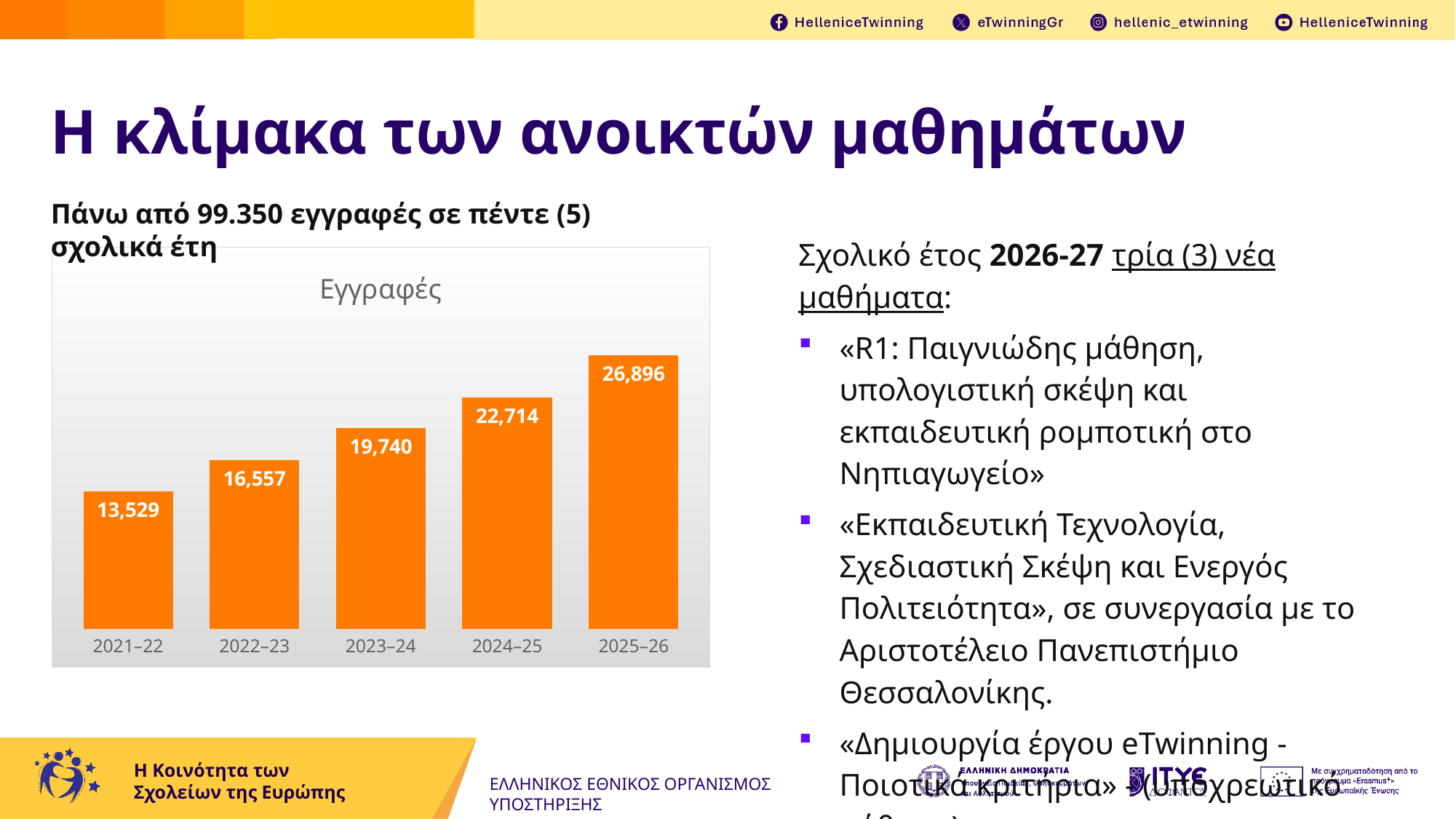
Do the values in the Εγγραφές chart rise or fall from 2021–22 to 2025–26? Rise How many school years are shown in the Εγγραφές chart? 5 Which school year has the highest value in the Εγγραφές chart? 2025–26 What is the value for 2021–22 in the Εγγραφές chart? 13,529 What is the difference between the values for 2024–25 and 2023–24 in the Εγγραφές chart? 2,974 Which is larger in the Εγγραφές chart, the value for 2022–23 or the value for 2024–25? 2024–25 What is the title of the chart on the slide? Εγγραφές What is the difference between the values for 2025–26 and 2021–22 in the Εγγραφές chart? 13,367 What is the value for 2023–24 in the Εγγραφές chart? 19,740 Which school year has the lowest value in the Εγγραφές chart? 2021–22 What is the value for 2025–26 in the Εγγραφές chart? 26,896 What kind of chart is used to show Εγγραφές? Bar chart